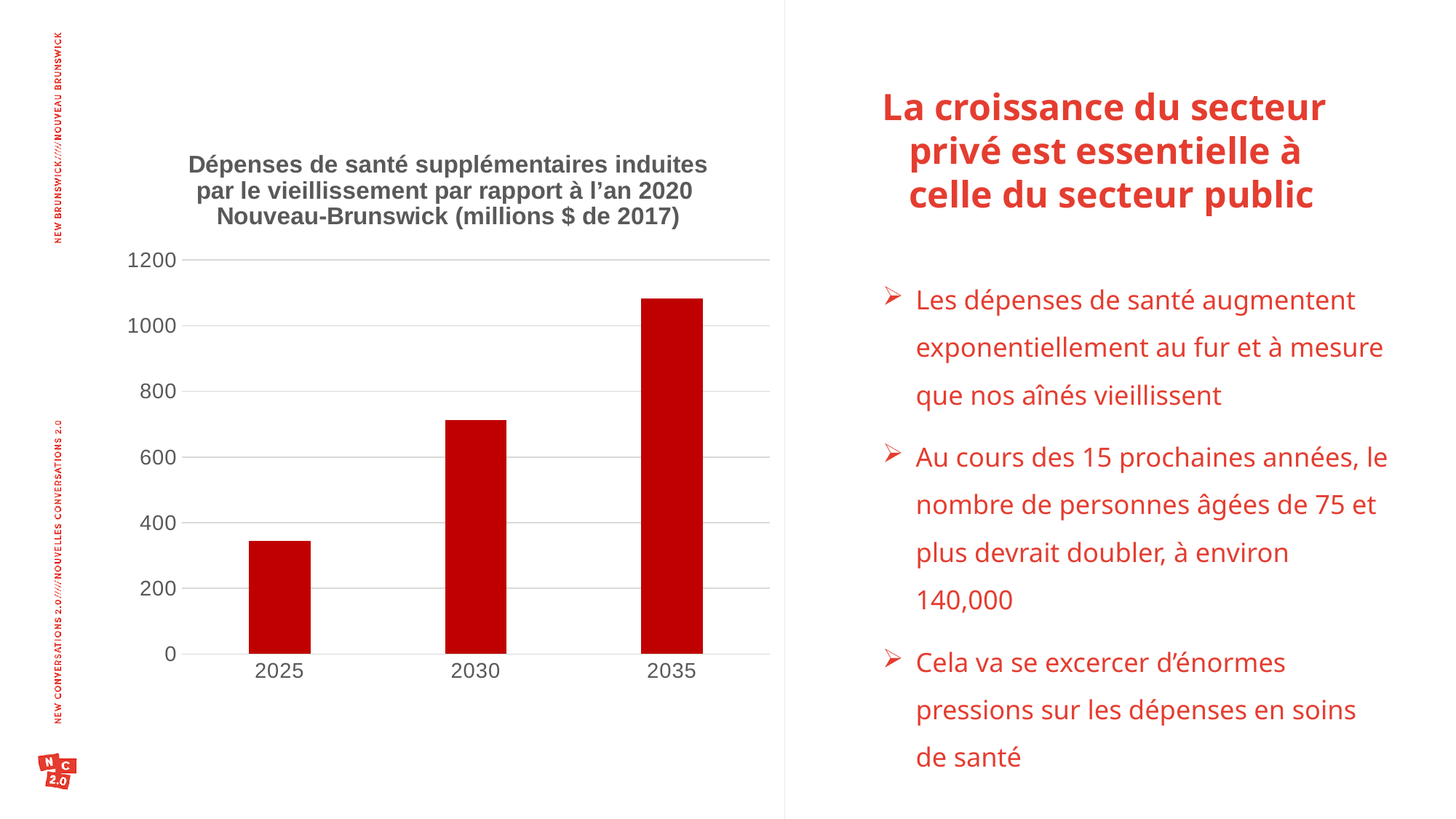
Which year has the lowest additional health spending in the chart? 2025 What kind of chart is shown on the slide? bar chart Which year has the highest additional health spending in the chart? 2035 Do the values rise or fall from 2025 to 2035? rise Is the value for 2025 greater or less than 400? less Is the value for 2030 greater or less than 600? greater How many bars (years) are plotted in the chart? 3 Is the value for 2035 greater or less than 1000? greater What is the highest value shown on the vertical axis of the chart? 1200 What colour are the bars in the chart? red Which is larger, the value for 2030 or the value for 2035? 2035